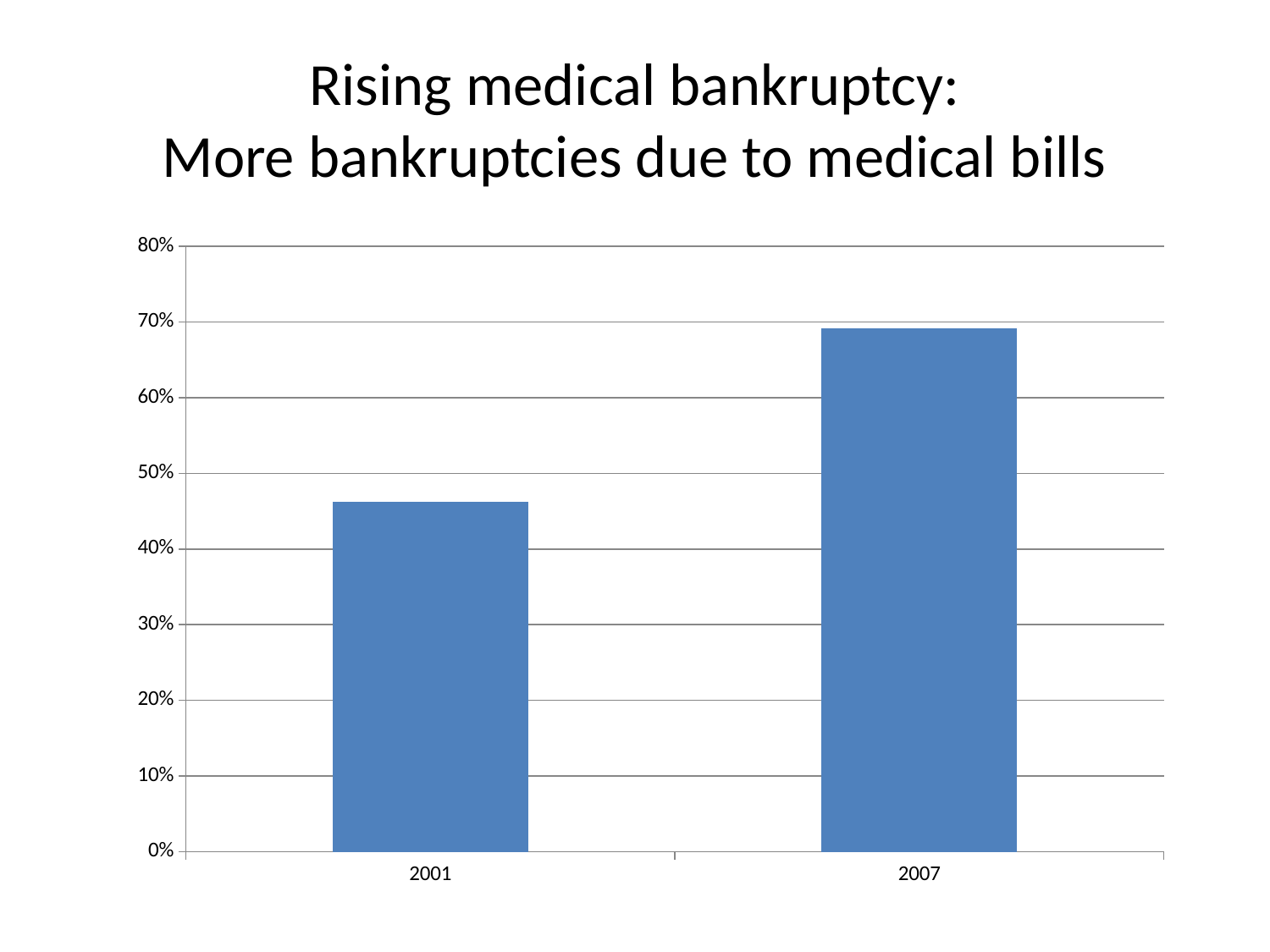
What is the title of the slide? Rising medical bankruptcy: More bankruptcies due to medical bills Which year has the higher bar? 2007 Is the value for 2007 greater or less than 70%? less Which year has the lower bar? 2001 Is the value for 2001 greater or less than 40%? greater Is the value for 2001 greater or less than 50%? less What is the highest value shown on the y axis? 80% How many categories are plotted on the x axis? 2 What kind of chart is shown on the slide? bar chart Do the values rise or fall from 2001 to 2007? rise Is the bar for 2007 larger or smaller than the bar for 2001? larger